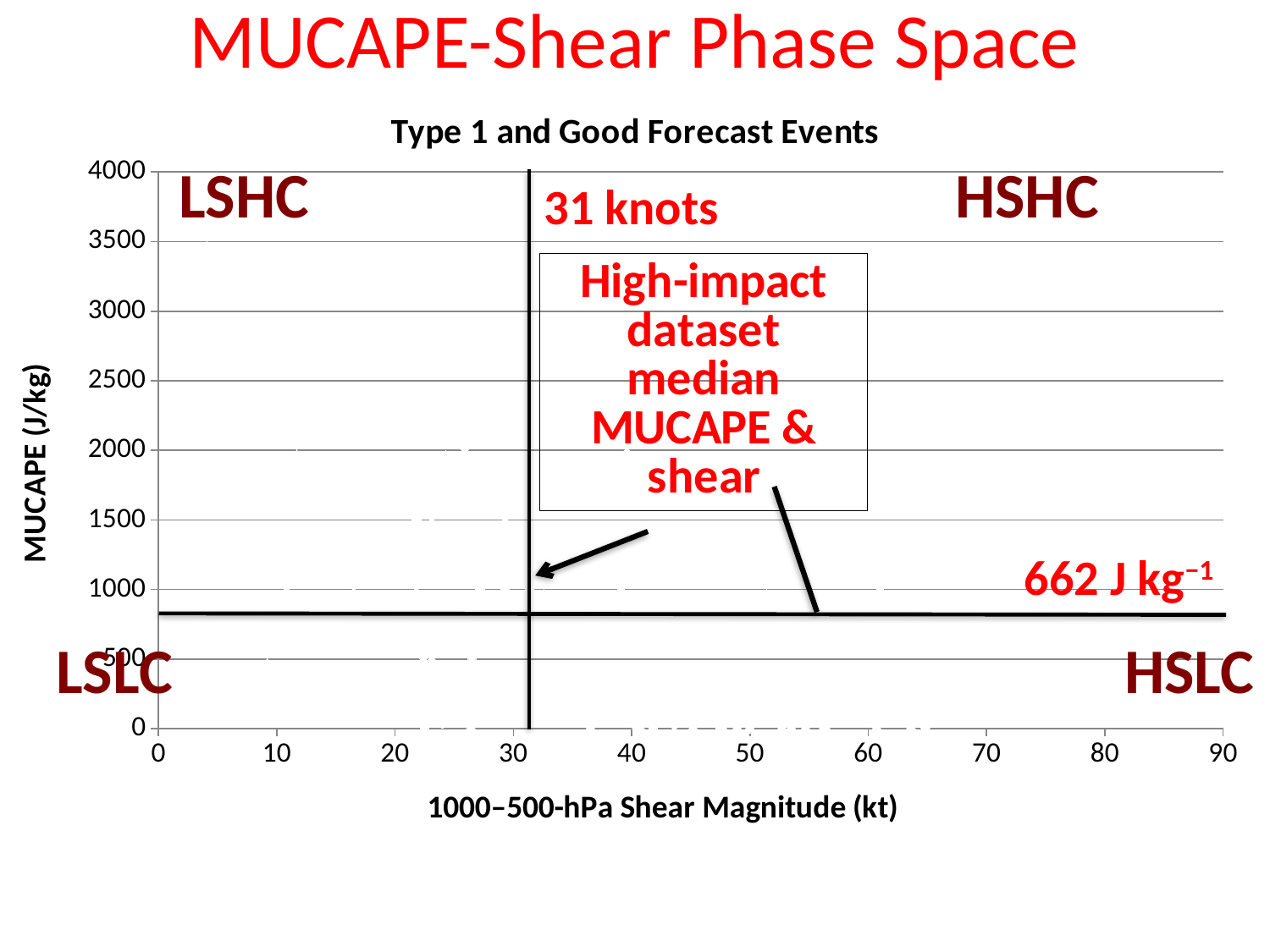
Is the vertical reference line at a shear value greater or less than 40? less Is the horizontal reference line at a MUCAPE value greater or less than 1000? less What is the maximum value shown on the y axis? 4000 What shear value does the vertical reference line mark? 31 knots What is the title of the chart? Type 1 and Good Forecast Events What is the label of the y axis? MUCAPE (J/kg) What MUCAPE value does the horizontal reference line mark? 662 J kg⁻¹ What kind of chart is this? scatter chart What is the maximum value shown on the x axis? 90